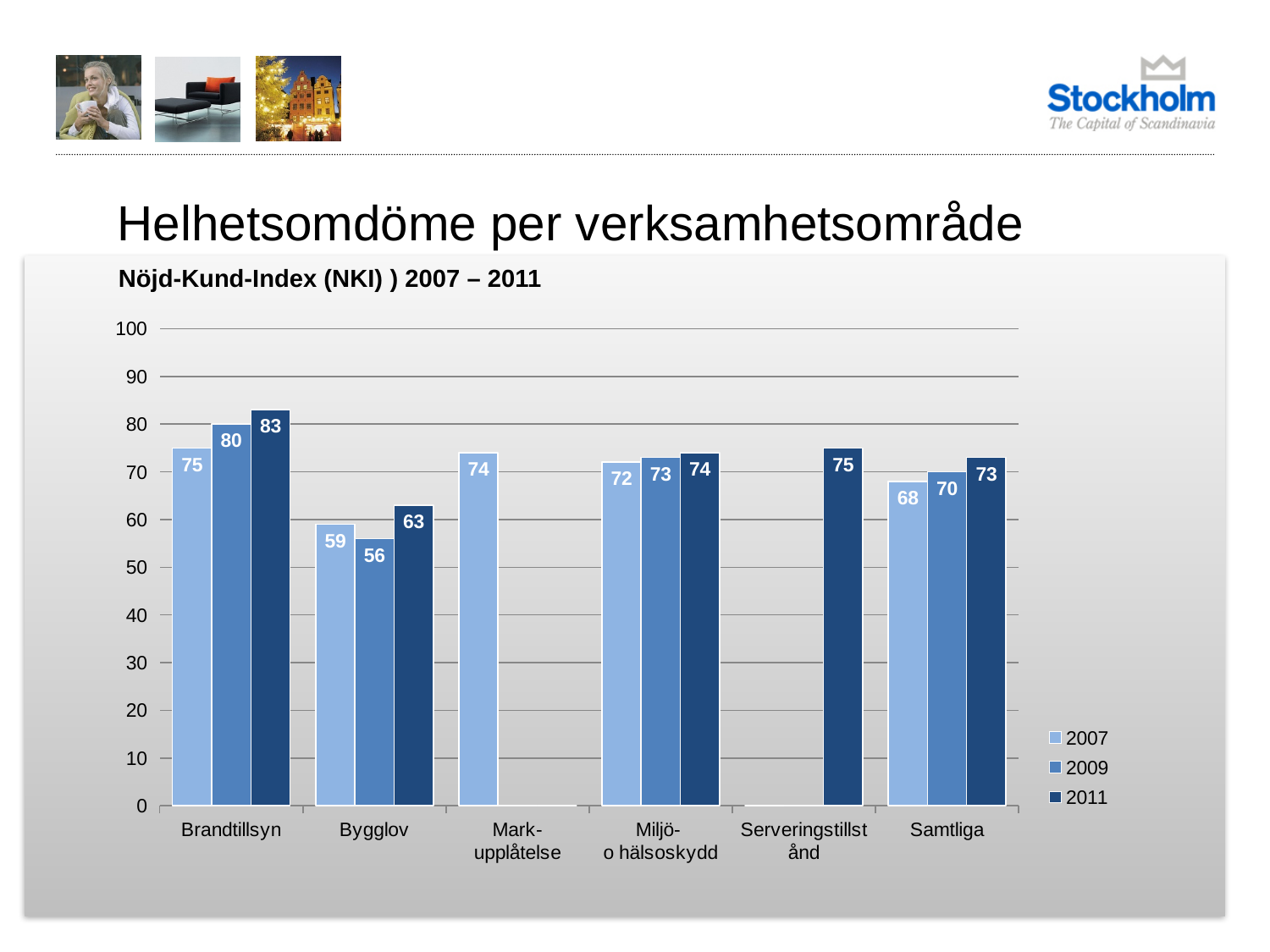
What is the 2011 value for Brandtillsyn? 83 What is the 2009 value for Bygglov? 56 What is the difference between the 2011 and 2007 values for Samtliga? 5 What kind of chart is shown? Bar chart What is the 2011 value for Serveringstillstånd? 75 Which category has the lowest 2007 value? Bygglov How many categories are shown on the x axis? 6 How many series does the legend list? 3 Which category has the highest 2011 value? Brandtillsyn Which is larger, the 2009 value for Brandtillsyn or the 2009 value for Miljö- o hälsoskydd? Brandtillsyn Do the values for Samtliga rise or fall from 2007 to 2011? Rise What is the 2007 value for Mark-upplåtelse? 74